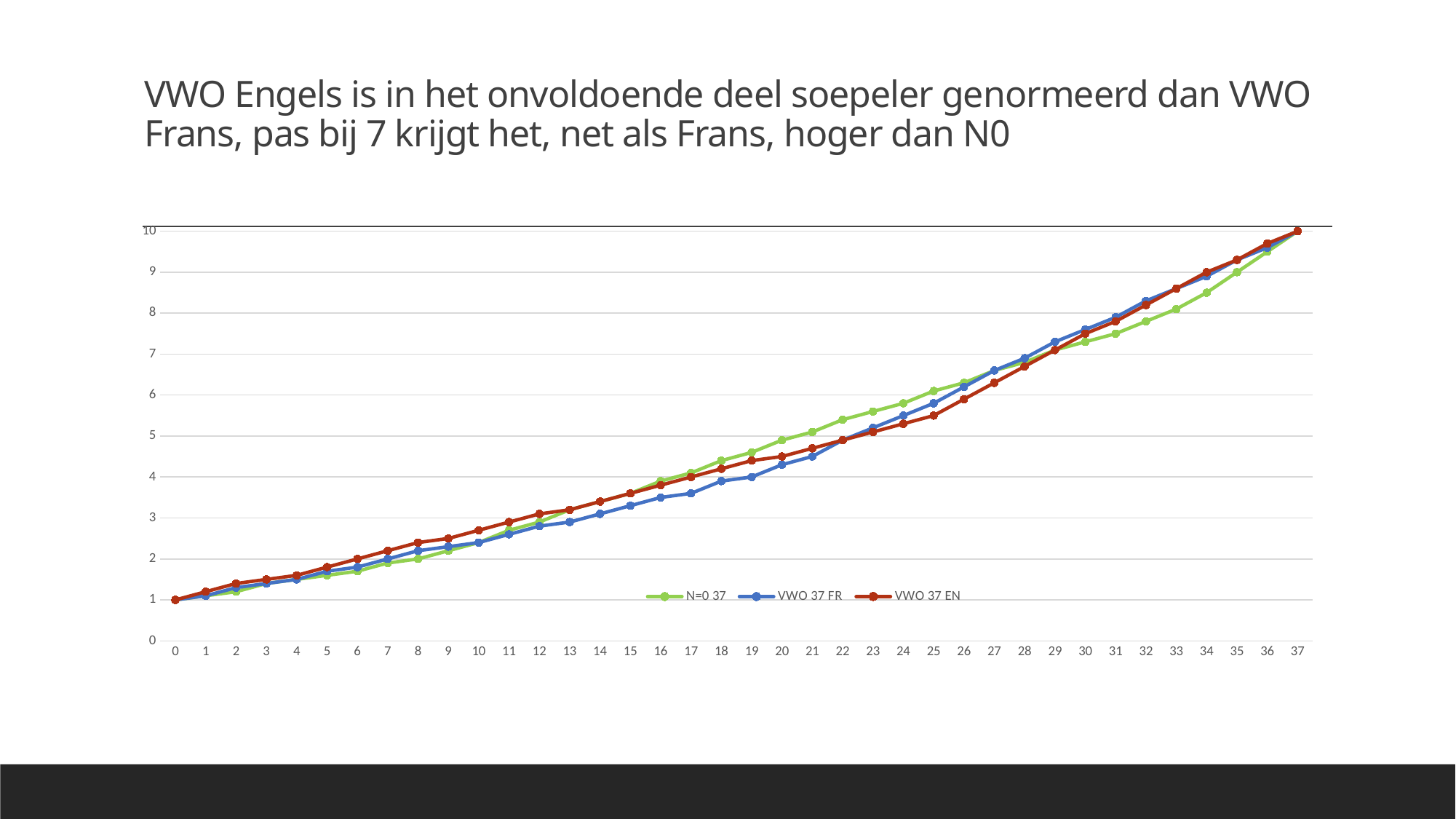
What are the names of the series in the legend? N=0 37, VWO 37 FR, VWO 37 EN Is the value for VWO 37 EN at x = 25 greater or less than 6? less How many series does the legend list? 3 Do the values of the series rise or fall as x increases from 0 to 37? rise What is the value of VWO 37 EN at x = 0? 1 Is the value for N=0 37 at x = 34 greater or less than 8? greater At x = 19, which is larger: N=0 37 or VWO 37 FR? N=0 37 What kind of chart is shown on the slide? line chart Is the value for VWO 37 FR at x = 16 greater or less than 4? less What colour is the line for VWO 37 EN? red At x = 34, which is larger: VWO 37 EN or N=0 37? VWO 37 EN What is the value of VWO 37 FR at x = 37? 10